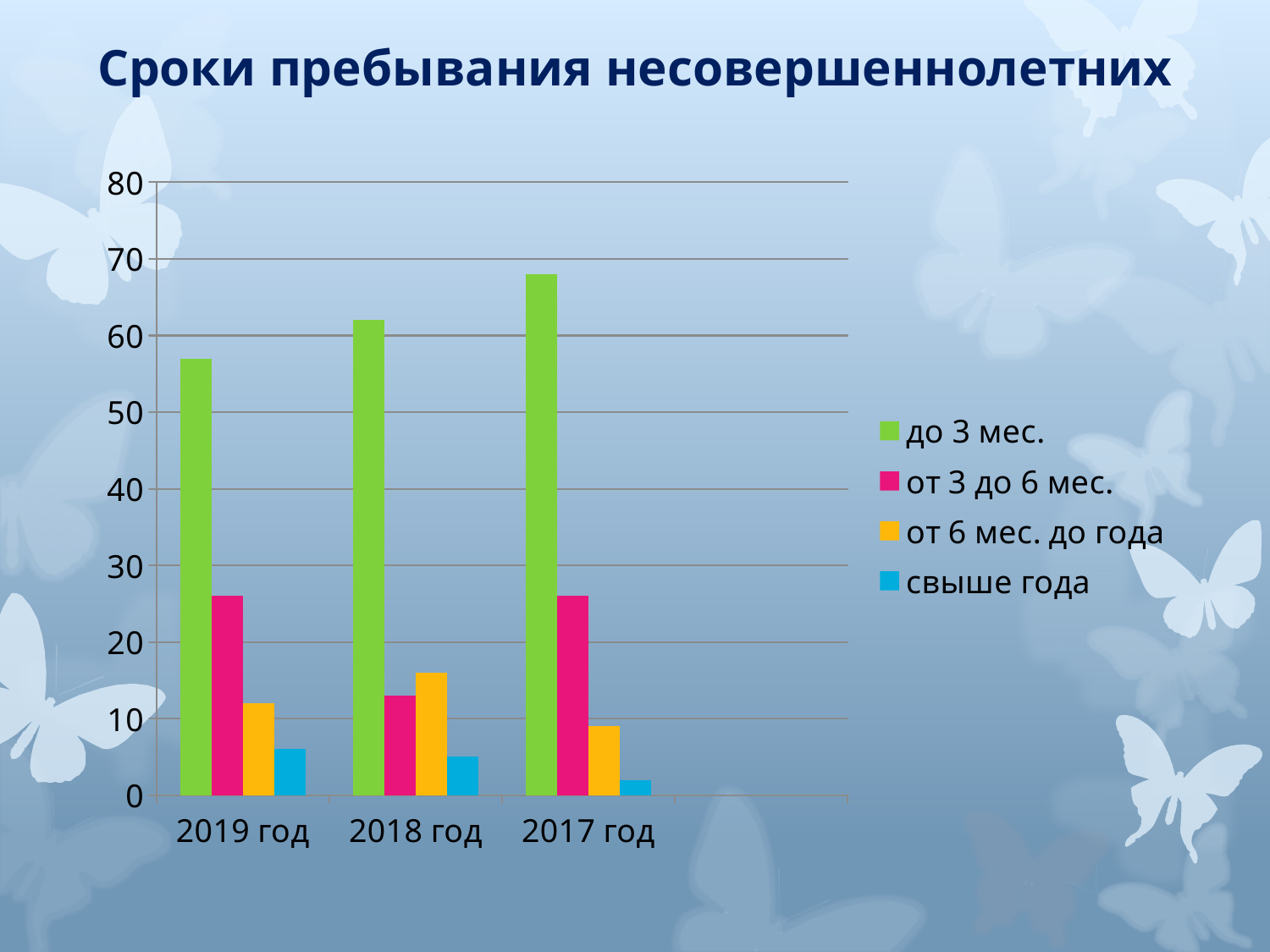
Which year has the highest value for the series "до 3 мес."? 2017 год Is the value for "от 3 до 6 мес." in 2018 год greater or less than 20? less Is the value for "до 3 мес." in 2018 год greater or less than 60? greater What is the title of the slide? Сроки пребывания несовершеннолетних Which is larger in 2018 год: "от 3 до 6 мес." or "от 6 мес. до года"? от 6 мес. до года How many series does the legend list? 4 Which year has the lowest value for the series "до 3 мес."? 2019 год How many year categories are shown on the x axis? 3 Is the value for "до 3 мес." in 2019 год greater or less than 60? less Which year has the lowest value for the series "свыше года"? 2017 год What kind of chart is shown on the slide? bar chart Does the value for "до 3 мес." rise or fall moving from 2019 год to 2017 год along the x axis? rise